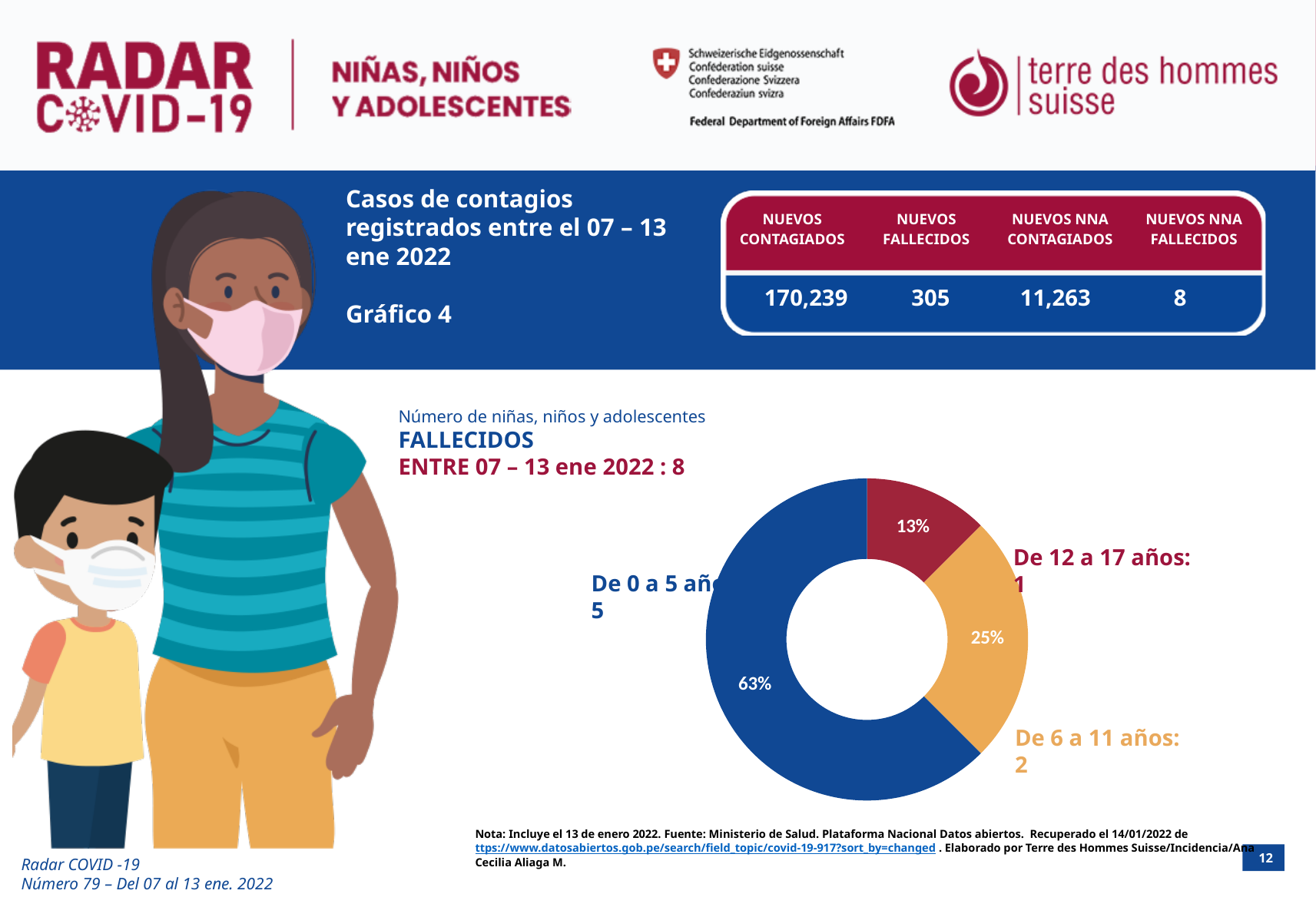
Which age group has the smallest share of the donut chart? De 12 a 17 años What kind of chart is used to show the number of children and adolescents who died between 07 and 13 January 2022? Donut (pie) chart Which age group has the largest share of the donut chart? De 0 a 5 años What percentage of the donut chart corresponds to the 'De 12 a 17 años' group? 13% What percentage of the donut chart corresponds to the 'De 6 a 11 años' group? 25% What is the total number of children and adolescents who died between 07 and 13 January 2022 according to the chart? 8 What is the difference in deaths between the 'De 0 a 5 años' group and the 'De 6 a 11 años' group? 3 How many age groups are shown in the donut chart? 3 How many deaths are shown for the 'De 12 a 17 años' group? 1 How many deaths are shown for the 'De 0 a 5 años' group? 5 What percentage of the donut chart corresponds to the 'De 0 a 5 años' group? 63% How many deaths are shown for the 'De 6 a 11 años' group? 2